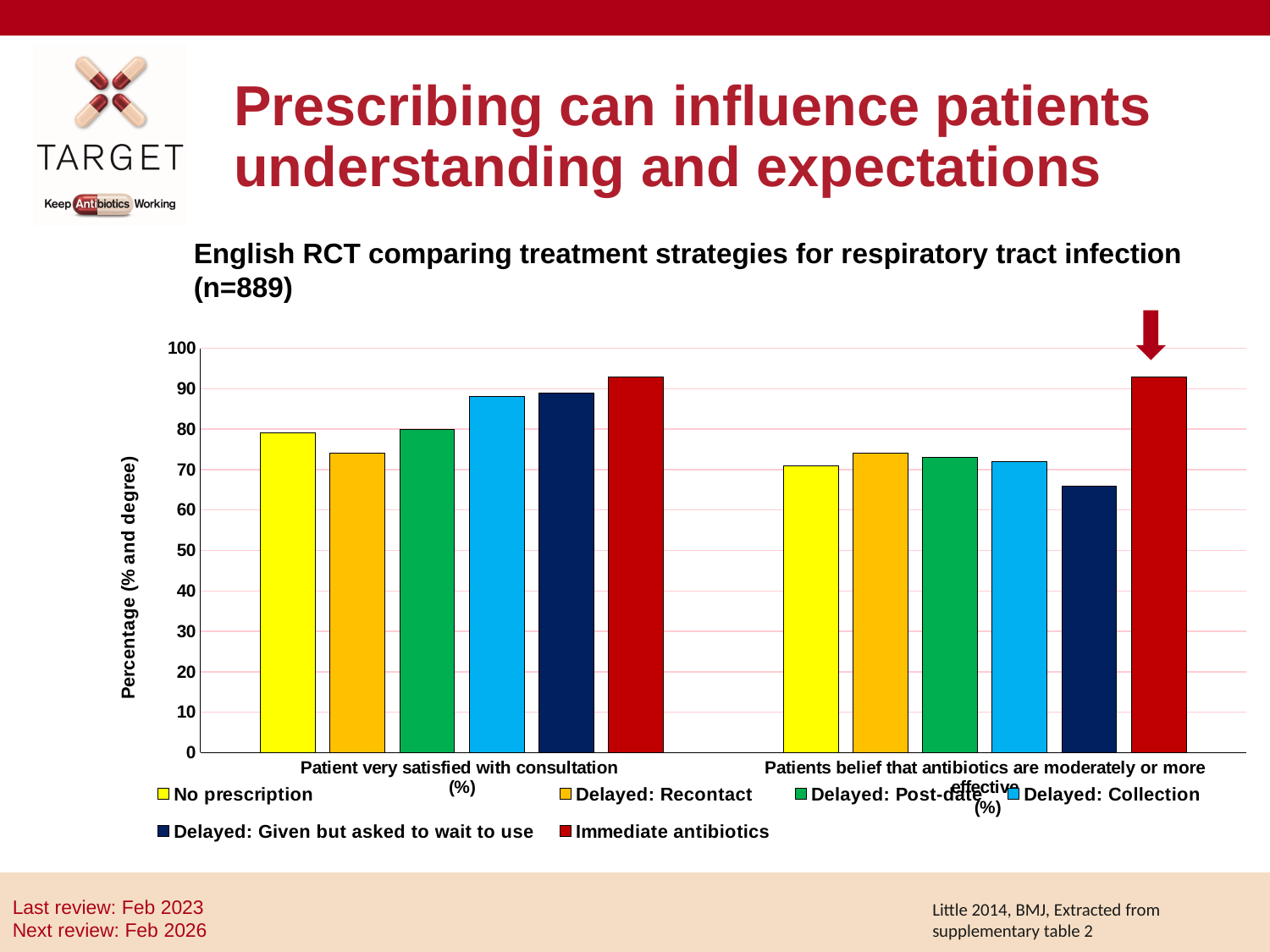
Is the value for Immediate antibiotics in 'Patient very satisfied with consultation (%)' greater or less than 80? greater Which series has the highest value for 'Patients belief that antibiotics are moderately or more effective (%)'? Immediate antibiotics What colour represents the Immediate antibiotics series? Red Which is larger for 'Patients belief that antibiotics are moderately or more effective (%)': Immediate antibiotics or No prescription? Immediate antibiotics Which series has the lowest value for 'Patients belief that antibiotics are moderately or more effective (%)'? Delayed: Given but asked to wait to use Which series has the highest value for 'Patient very satisfied with consultation (%)'? Immediate antibiotics How many series does the legend list? 6 Is the value for Delayed: Collection larger for 'Patient very satisfied with consultation (%)' or for 'Patients belief that antibiotics are moderately or more effective (%)'? Patient very satisfied with consultation (%) What kind of chart is shown on the slide? Bar chart Is the value for Delayed: Given but asked to wait to use in 'Patients belief that antibiotics are moderately or more effective (%)' greater or less than 70? less Which series has the lowest value for 'Patient very satisfied with consultation (%)'? Delayed: Recontact How many categories are shown on the x axis? 2